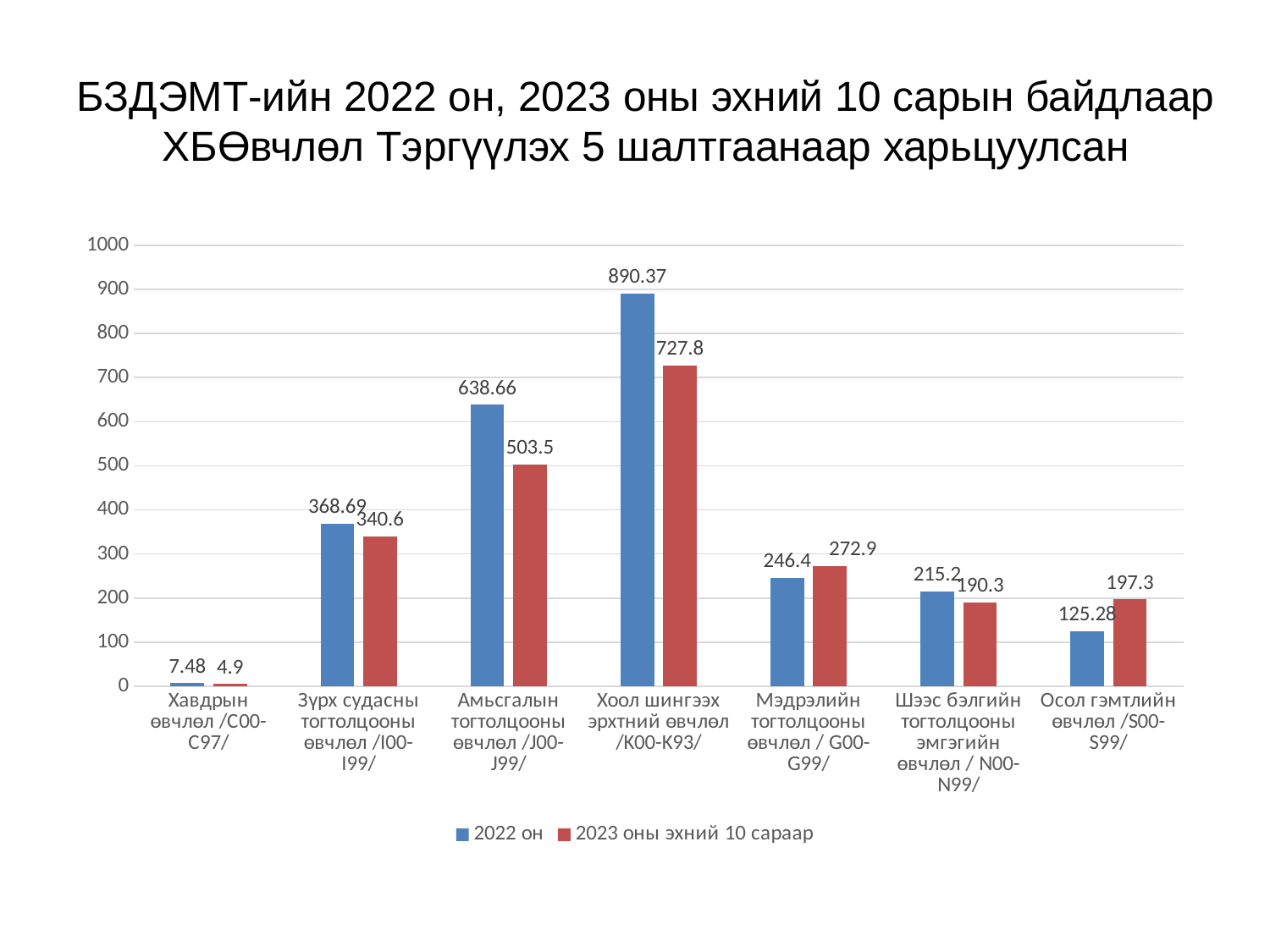
What kind of chart is shown on the slide? Bar chart What is the 2022 он value for Хоол шингээх эрхтний өвчлөл /K00-K93/? 890.37 What is the difference between the 2023 оны эхний 10 сараар and 2022 он values for Мэдрэлийн тогтолцооны өвчлөл /G00-G99/? 26.5 What is the 2022 он value for Осол гэмтлийн өвчлөл /S00-S99/? 125.28 How many series does the legend list? 2 For Осол гэмтлийн өвчлөл /S00-S99/, which series has the larger value, 2022 он or 2023 оны эхний 10 сараар? 2023 оны эхний 10 сараар Which category has the highest 2022 он value? Хоол шингээх эрхтний өвчлөл /K00-K93/ What is the 2023 оны эхний 10 сараар value for Амьсгалын тогтолцооны өвчлөл /J00-J99/? 503.5 Which category has the lowest 2023 оны эхний 10 сараар value? Хавдрын өвчлөл /C00-C97/ Is the 2022 он value for Амьсгалын тогтолцооны өвчлөл /J00-J99/ greater or less than 600? greater What is the difference between the 2022 он and 2023 оны эхний 10 сараар values for Хоол шингээх эрхтний өвчлөл /K00-K93/? 162.57 How many categories are shown on the x axis? 7